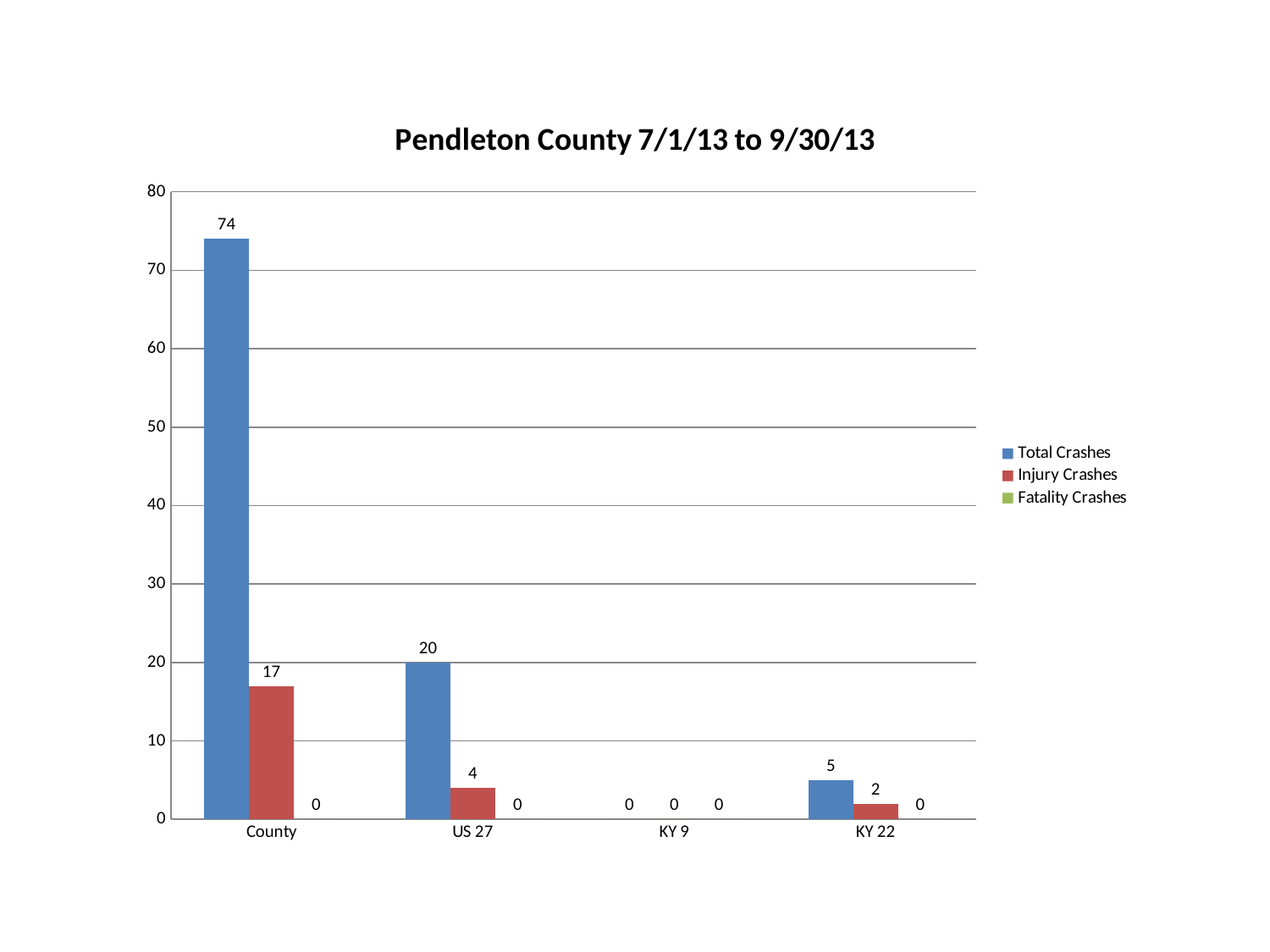
What is the value of Total Crashes for County? 74 What is the value of Injury Crashes for KY 22? 2 How many series does the legend list? 3 What is the difference between Total Crashes and Injury Crashes for County? 57 What kind of chart is shown on the slide? Bar chart How many categories are shown on the x axis? 4 Which is larger, Total Crashes for US 27 or Total Crashes for KY 22? Total Crashes for US 27 What is the value of Total Crashes for KY 9? 0 What is the value of Injury Crashes for US 27? 4 What is the title of the chart? Pendleton County 7/1/13 to 9/30/13 Which category has the lowest Total Crashes value? KY 9 Which category has the highest Total Crashes value? County